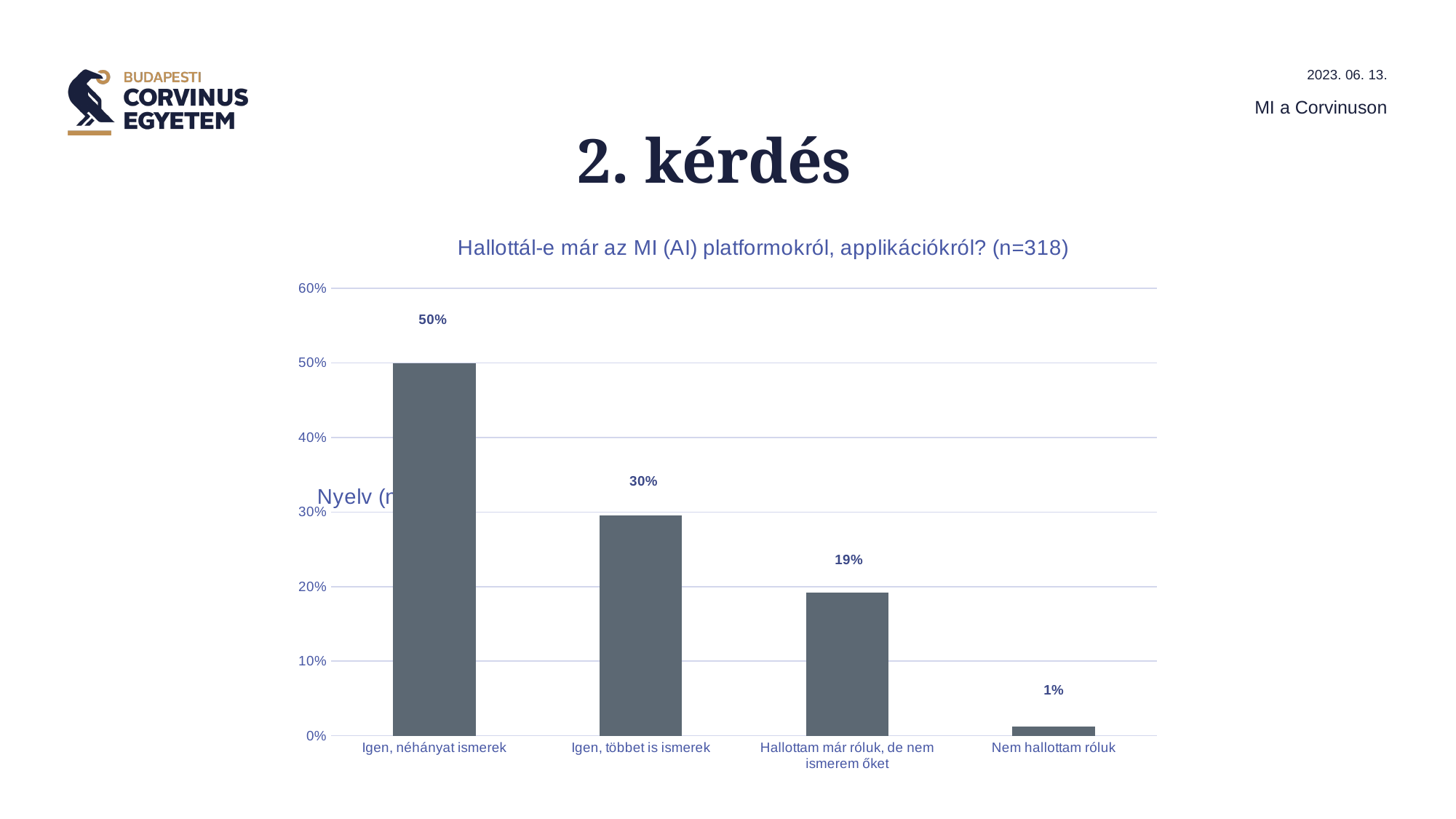
What kind of chart is shown on the slide? bar chart What is the difference between the values for "Igen, néhányat ismerek" and "Igen, többet is ismerek"? 20% What is the value for "Igen, néhányat ismerek"? 50% Is the value for "Hallottam már róluk, de nem ismerem őket" greater or less than 20%? less Which is larger, the value for "Igen, többet is ismerek" or the value for "Hallottam már róluk, de nem ismerem őket"? Igen, többet is ismerek What is the value for "Nem hallottam róluk"? 1% Which category has the highest value? Igen, néhányat ismerek What is the value for "Hallottam már róluk, de nem ismerem őket"? 19% What is the title of the chart? Hallottál-e már az MI (AI) platformokról, applikációkról? (n=318) What is the value for "Igen, többet is ismerek"? 30% How many categories are shown on the x axis? 4 Which category has the lowest value? Nem hallottam róluk